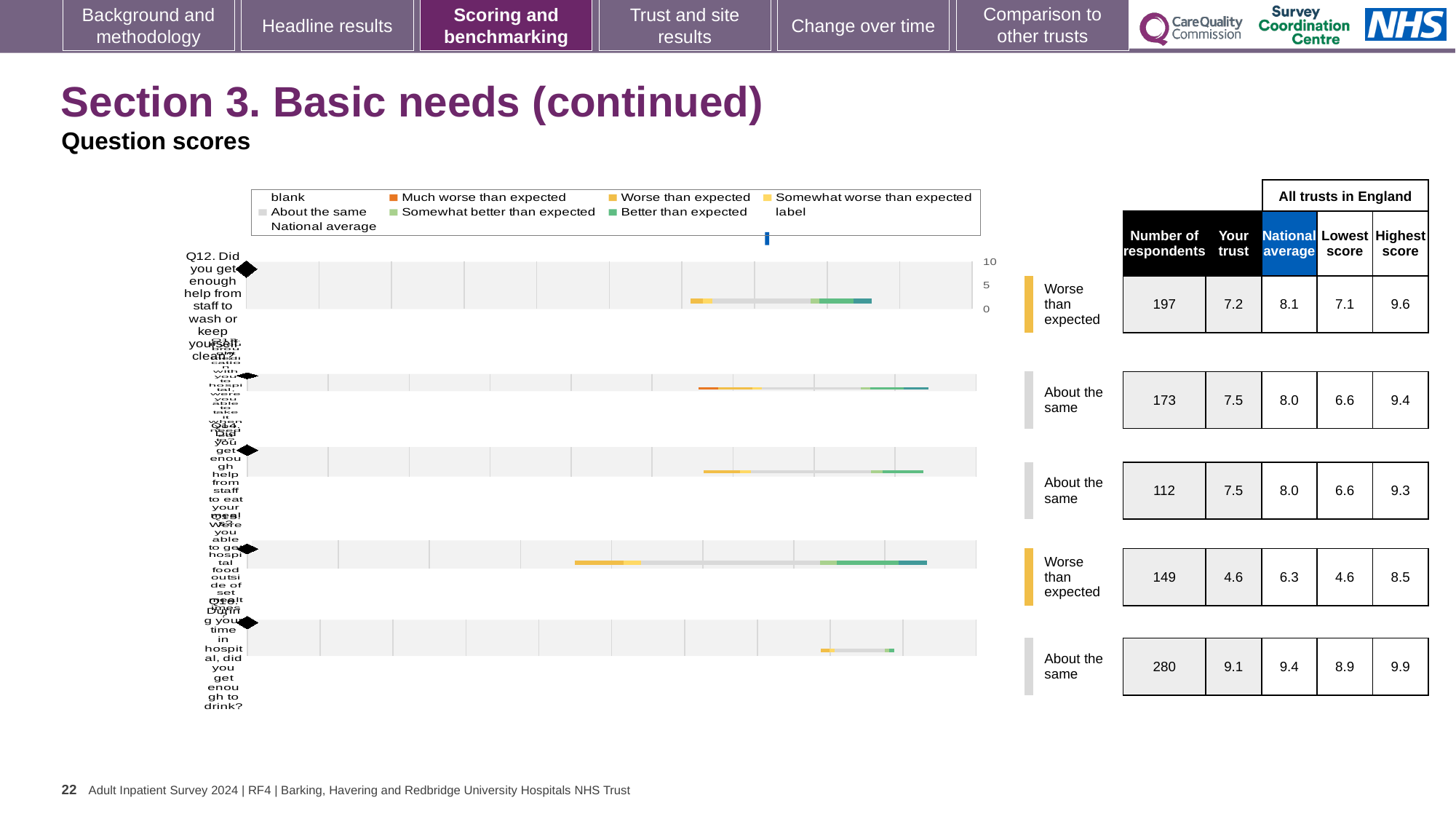
What colour represents 'Much worse than expected' in the legend? orange For Q12, what is the difference between the national average and the 'Your trust' score? 0.9 Which question row has the highest 'Your trust' score? Q16 (did you get enough to drink) What kind of chart is shown on the slide? bar chart How many question rows are labelled 'Worse than expected'? 2 For Q12, which is larger: the 'Your trust' score or the national average? National average What is the lowest 'Your trust' score shown in the table? 4.6 How many respondents are listed for Q12 (help from staff to wash or keep yourself clean)? 197 What is the 'Your trust' score for Q12 (help from staff to wash or keep yourself clean)? 7.2 What is the 'Your trust' score for the bottom row, Q16 (did you get enough to drink)? 9.1 What is the national average for Q16 (did you get enough to drink)? 9.4 How many question rows are plotted in the chart? 5